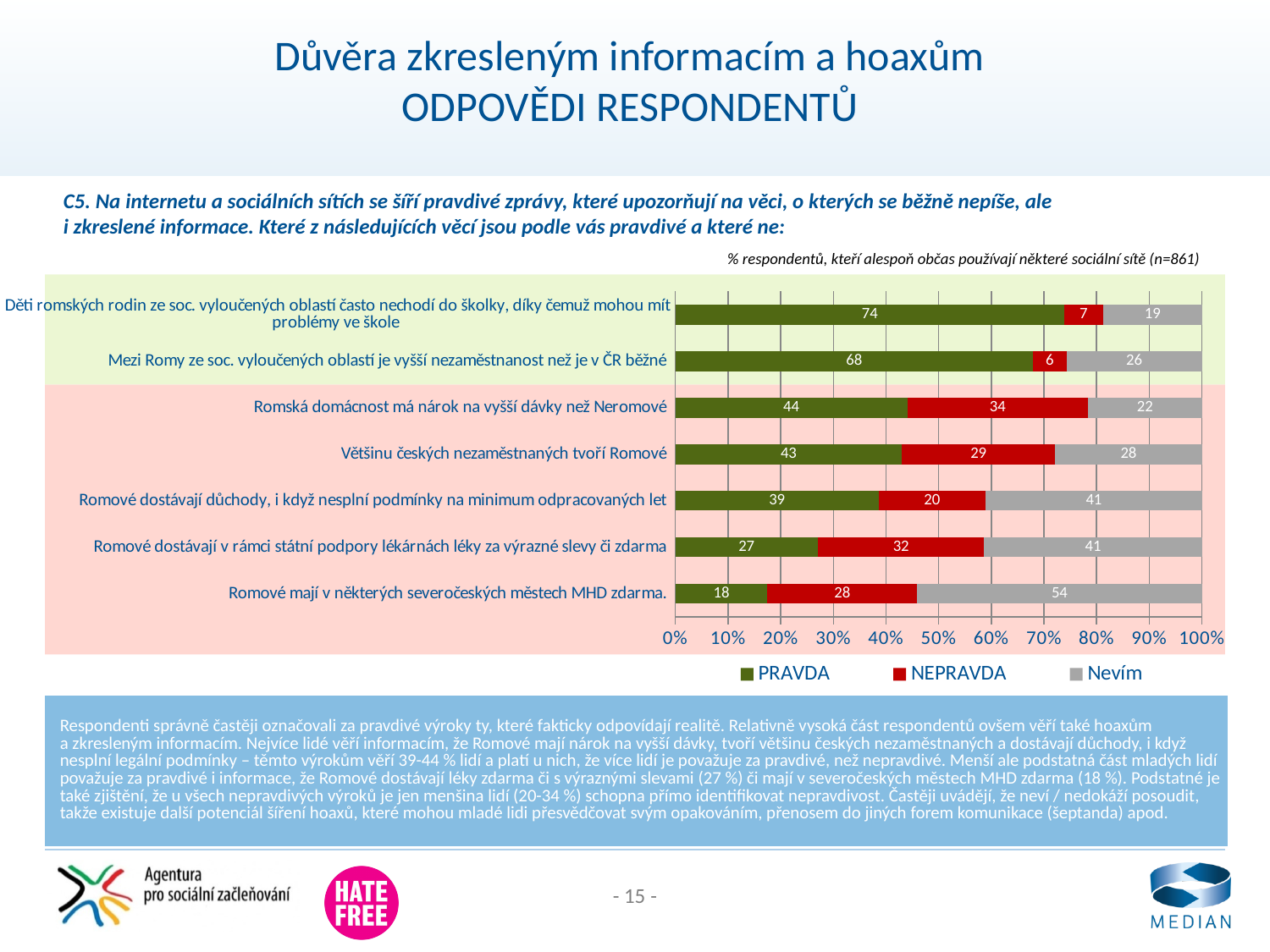
What is the NEPRAVDA value for 'Romská domácnost má nárok na vyšší dávky než Neromové'? 34 What type of chart is shown on the slide? stacked bar chart Which statement has the highest PRAVDA value? Děti romských rodin ze soc. vyloučených oblastí často nechodí do školky, díky čemuž mohou mít problémy ve škole How many series does the legend list? 3 Which statement has the lowest NEPRAVDA value? Mezi Romy ze soc. vyloučených oblastí je vyšší nezaměstnanost než je v ČR běžné How many statements (categories) are plotted in the chart? 7 What is the PRAVDA value for 'Mezi Romy ze soc. vyloučených oblastí je vyšší nezaměstnanost než je v ČR běžné'? 68 Which colour represents the Nevím series in the chart? grey What is the Nevím value for 'Romové mají v některých severočeských městech MHD zdarma.'? 54 For 'Většinu českých nezaměstnaných tvoří Romové', which is larger: the PRAVDA value or the NEPRAVDA value? PRAVDA What is the total of the three segments for 'Romská domácnost má nárok na vyšší dávky než Neromové'? 100 What is the difference between the PRAVDA values for 'Romové dostávají důchody, i když nesplní podmínky na minimum odpracovaných let' and 'Romové dostávají v rámci státní podpory lékárnách léky za výrazné slevy či zdarma'? 12